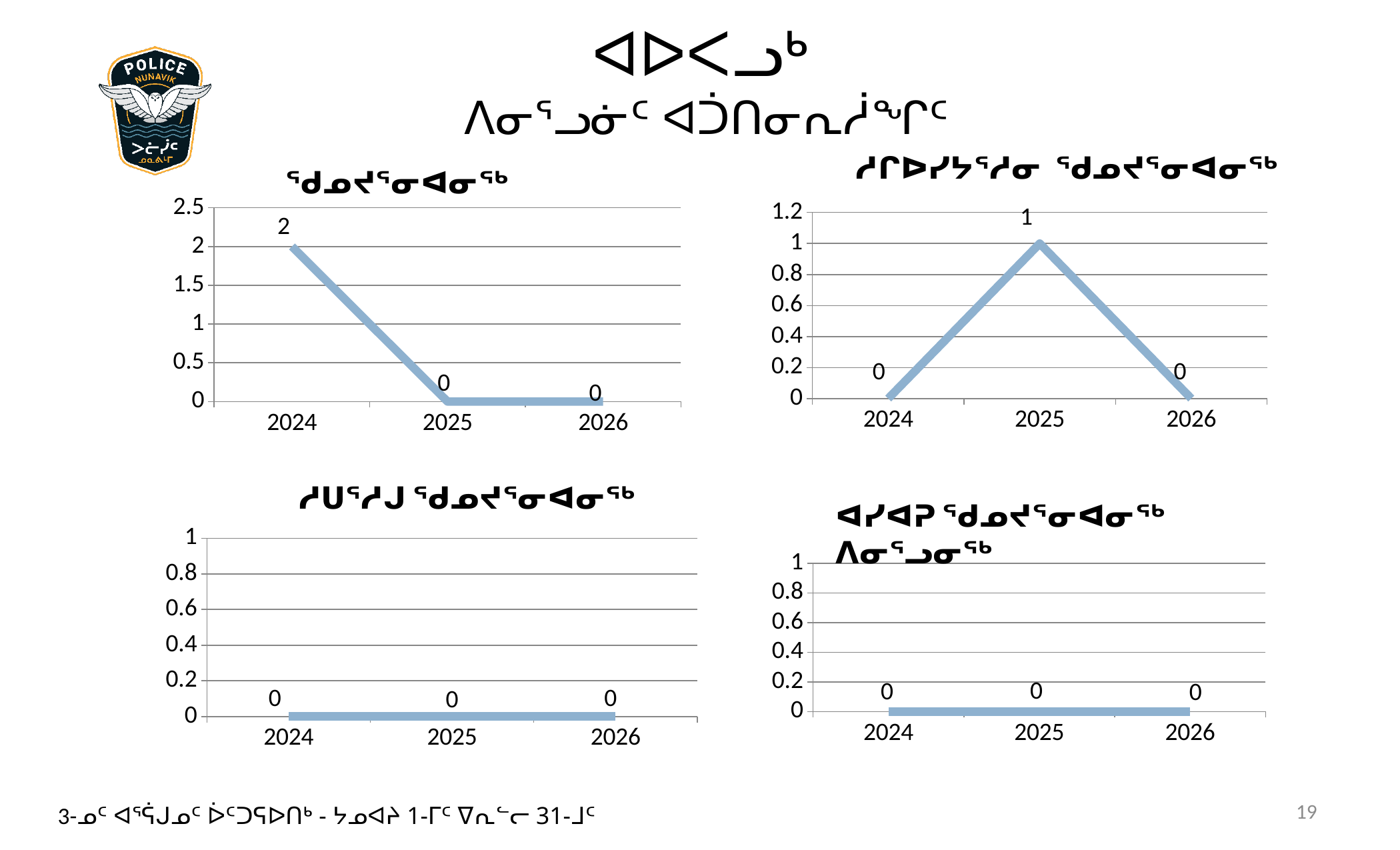
What kind of chart is the top-right chart? line chart In the top-right chart, what is the value for 2025? 1 In the top-left chart, what is the value for 2025? 0 In the bottom-left chart, what is the value for 2026? 0 In the top-right chart, which year has the highest value? 2025 In the bottom-right chart, what is the value for 2024? 0 In the top-right chart, is the value for 2025 larger than the value for 2026? Yes In the top-left chart, which year has the highest value? 2024 In the top-left chart, what is the difference between the values for 2024 and 2026? 2 In the top-left chart, what is the value for 2024? 2 How many years are plotted on the x axis of the bottom-left chart? 3 In the top-left chart, do the values rise or fall from 2024 to 2025? fall